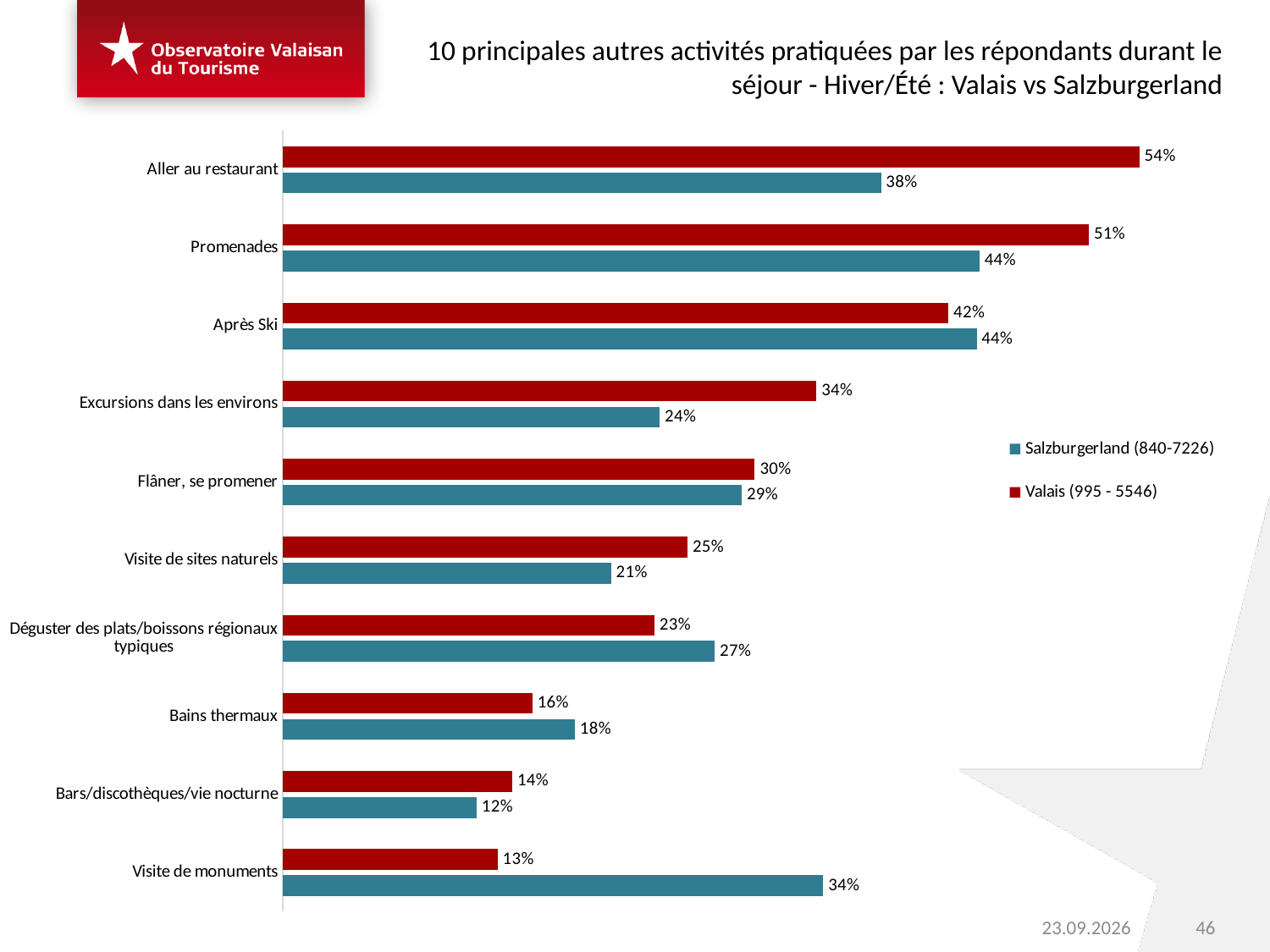
What is the value for Salzburgerland for 'Visite de monuments'? 34% What kind of chart is shown on the slide? Bar chart What is the difference between the Salzburgerland and Valais values for 'Visite de monuments'? 21% How many series does the legend list? 2 What is the difference between the Valais and Salzburgerland values for 'Aller au restaurant'? 16% Which activity has the lowest value for Salzburgerland? Bars/discothèques/vie nocturne How many activities are shown on the chart? 10 What is the value for Valais for 'Aller au restaurant'? 54% What is the value for Salzburgerland for 'Après Ski'? 44% Which activity has the highest value for Valais? Aller au restaurant For 'Excursions dans les environs', which series has the larger value, Valais or Salzburgerland? Valais For 'Déguster des plats/boissons régionaux typiques', which series has the larger value, Valais or Salzburgerland? Salzburgerland